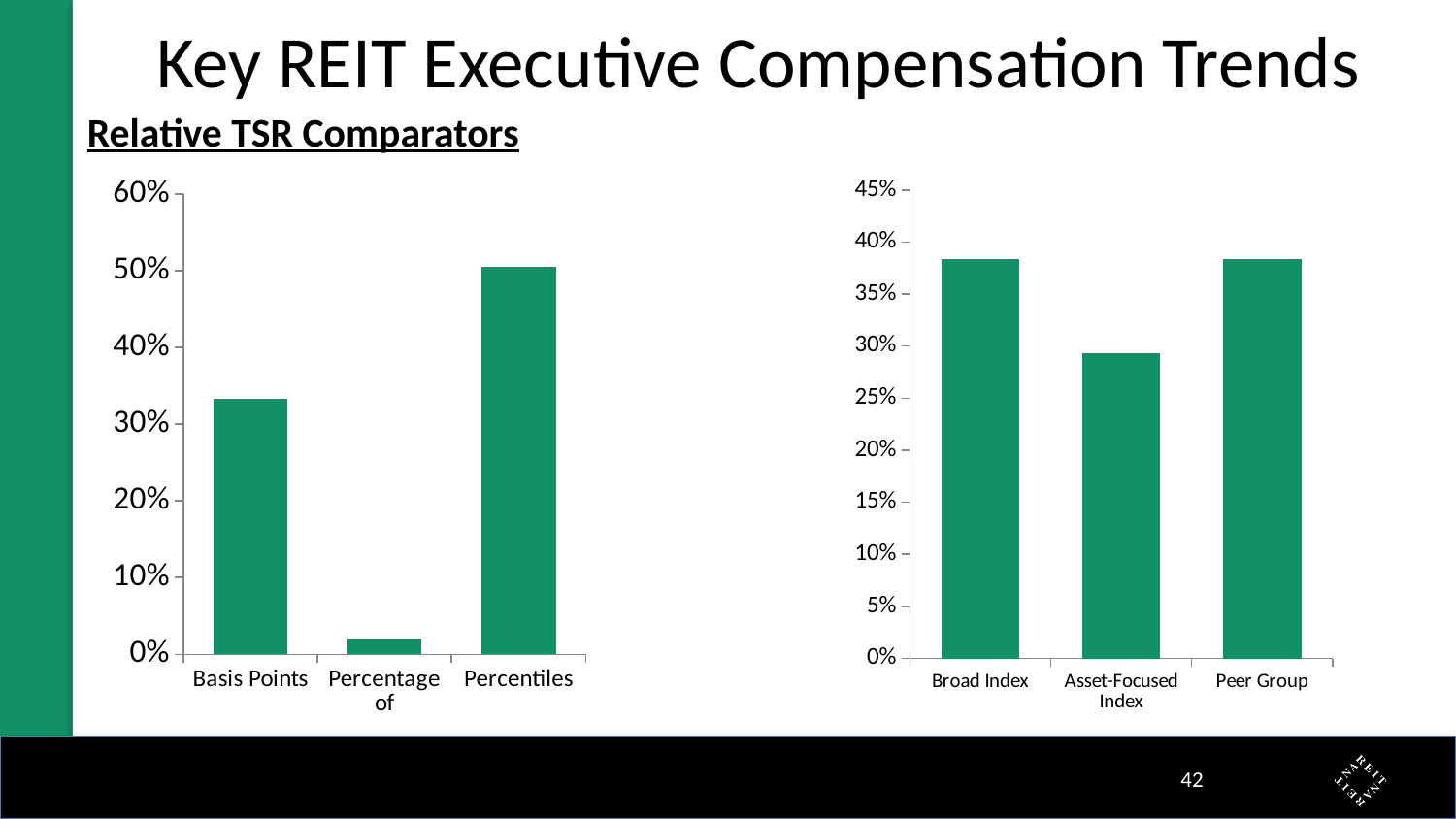
How many categories does the right chart show? 3 In the right chart, which is larger, Broad Index or Asset-Focused Index? Broad Index In the left chart, which category has the highest value? Percentiles In the left chart, is the value for Basis Points greater or less than 30%? greater In the left chart, which category has the lowest value? Percentage of In the left chart, which is larger, Basis Points or Percentiles? Percentiles In the left chart, is the value for Percentage of greater or less than 10%? less In the right chart, which category has the lowest value? Asset-Focused Index What kind of chart is the right chart on the slide? bar chart What kind of chart is the left chart on the slide? bar chart How many categories does the left chart show? 3